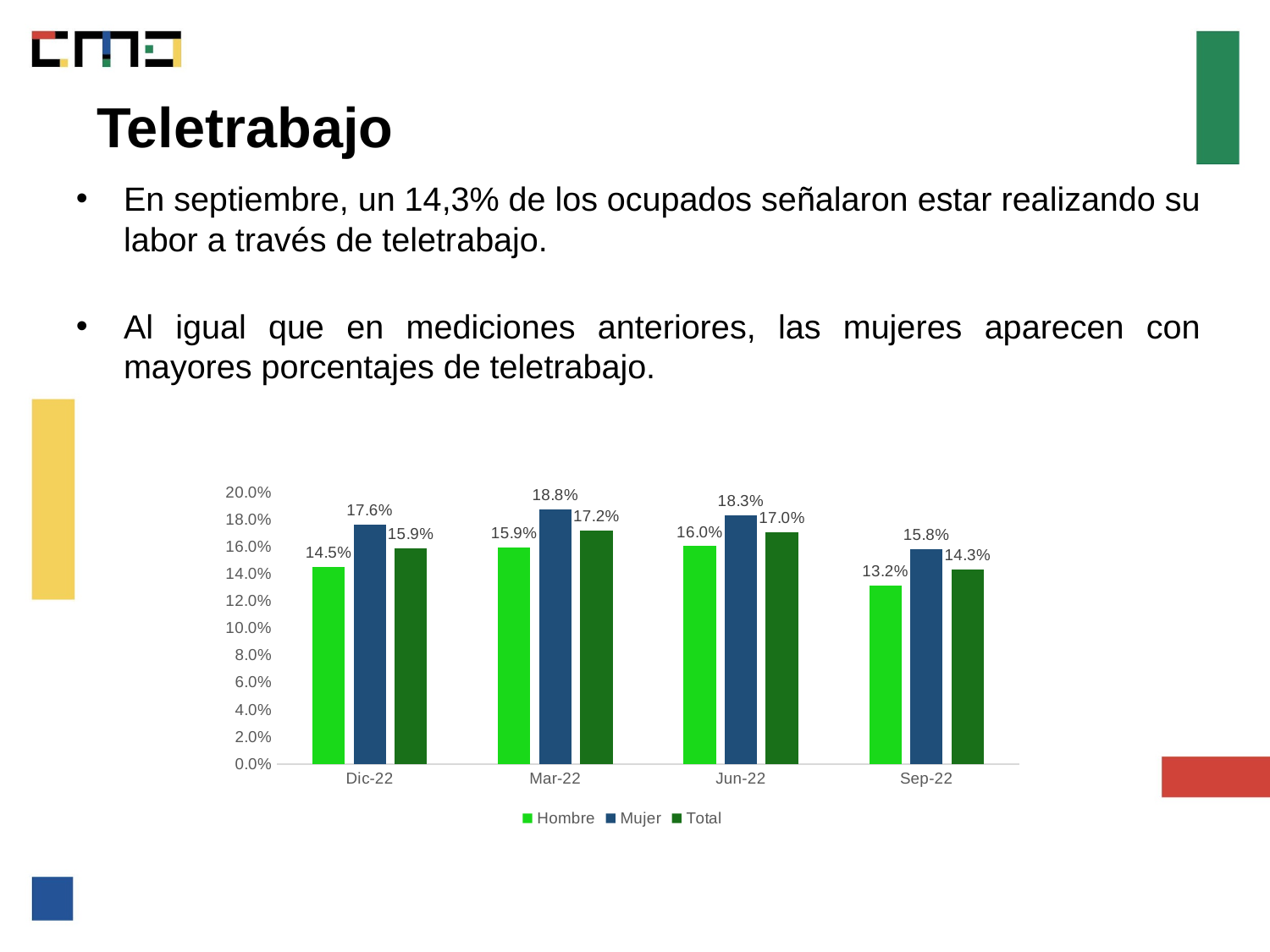
What is the value for Mujer in Mar-22? 18.8% What is the difference between the Mujer and Hombre values in Sep-22? 2.6% Does the Total value rise or fall from Jun-22 to Sep-22? fall What is the value for Hombre in Sep-22? 13.2% Is the Total value for Mar-22 greater or less than 16.0%? greater In which period is the Hombre value lowest? Sep-22 How many series does the legend list? 3 In which period is the Mujer value highest? Mar-22 What kind of chart is shown on the slide? bar chart How many periods are shown on the x axis? 4 What is the Total value for Jun-22? 17.0% Which is larger in Dic-22, the Hombre value or the Mujer value? Mujer